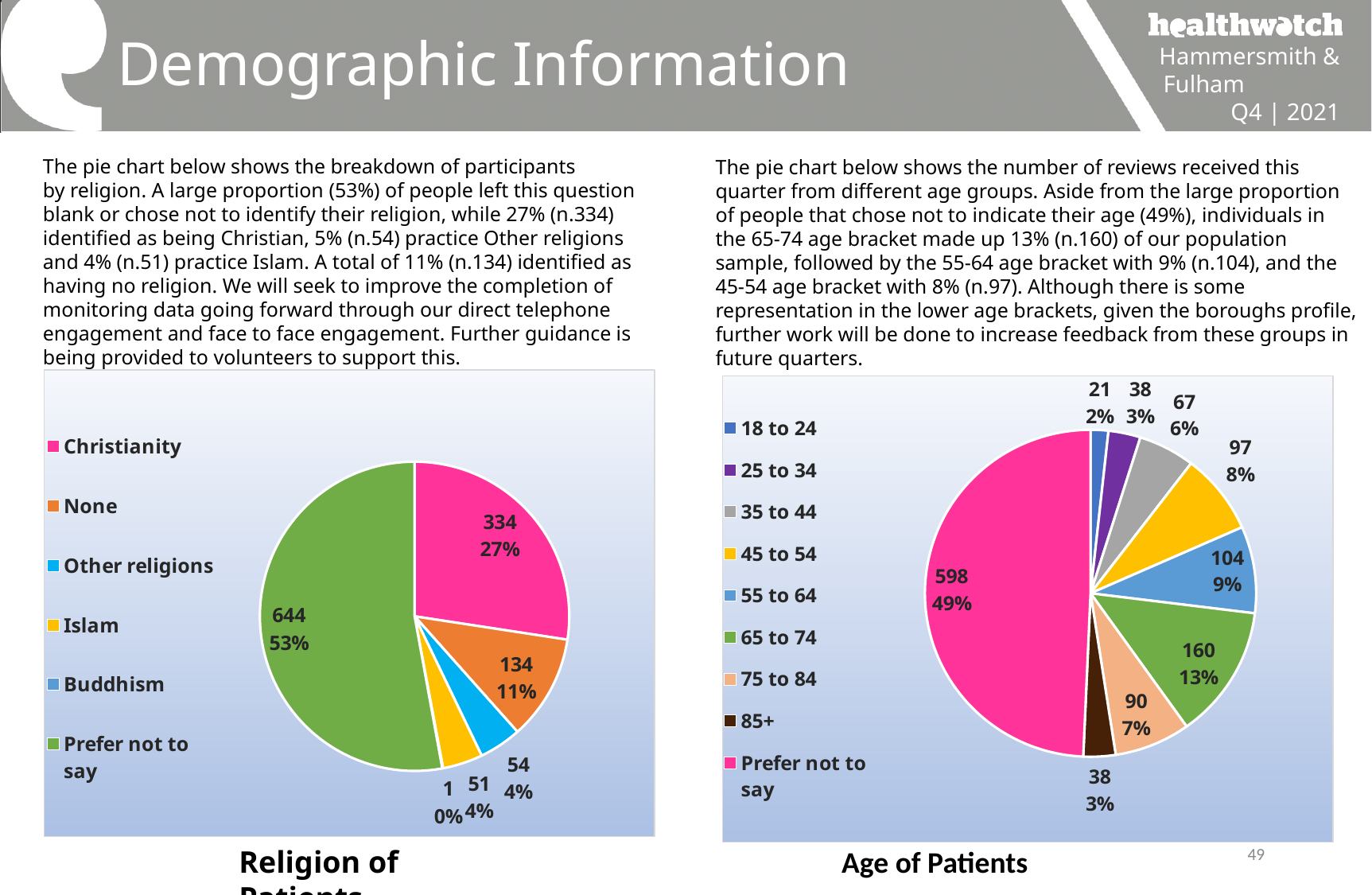
In the Age of Patients chart, what colour is the Prefer not to say slice? Pink What type of chart is the Religion of Patients chart? Pie chart In the Religion of Patients chart, what share of the pie is Prefer not to say? 53% In the Religion of Patients chart, which category has the smallest slice? Buddhism In the Religion of Patients chart, what is the difference between the None count and the Islam count? 83 In the Age of Patients chart, which is larger, the value for 45 to 54 or the value for 75 to 84? 45 to 54 In the Religion of Patients chart, how many participants identified as Christianity? 334 In the Age of Patients chart, how many reviews came from the 65 to 74 age group? 160 In the Age of Patients chart, which age group (excluding Prefer not to say) has the largest slice? 65 to 74 In the Age of Patients chart, how many categories does the legend list? 9 In the Age of Patients chart, what share of the pie is the 55 to 64 age group? 9% In the Religion of Patients chart, how many categories does the legend list? 6